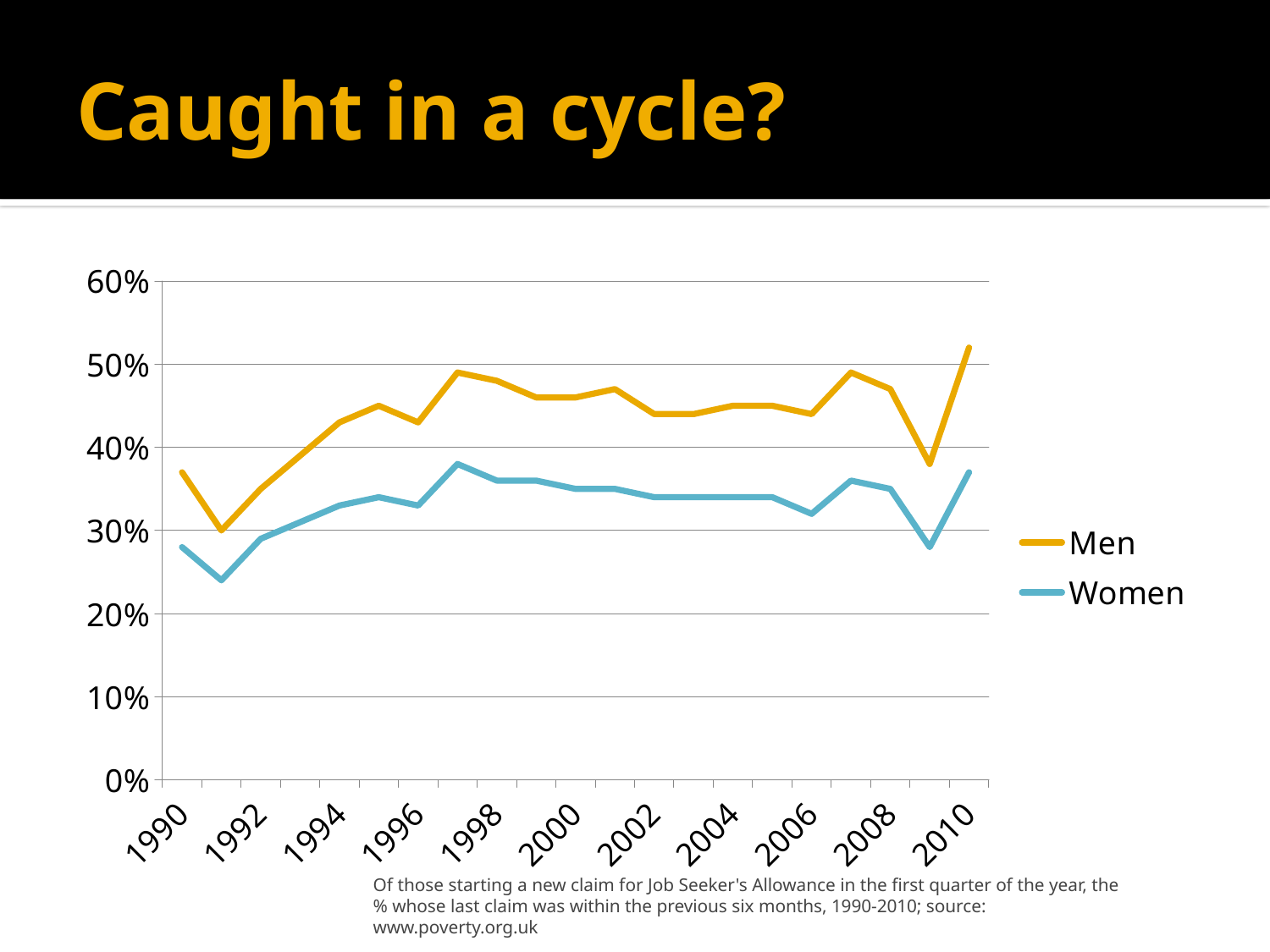
Which series has the higher values across the whole period, Men or Women? Men Is the value for Men in 2010 greater or less than 50%? greater In which year is the Men series at its highest? 2010 Which series is plotted in the orange line? Men How many series does the legend list? 2 In which year is the Men series at its lowest? 1991 In which year is the Women series at its lowest? 1991 Is the value for Women in 1991 greater or less than 30%? less What kind of chart is shown on the slide? Line chart Is the value for Men in 1990 greater or less than 40%? less Do the values for Men rise or fall between 1991 and 1995? rise Do the values for Women rise or fall between 2007 and 2009? fall